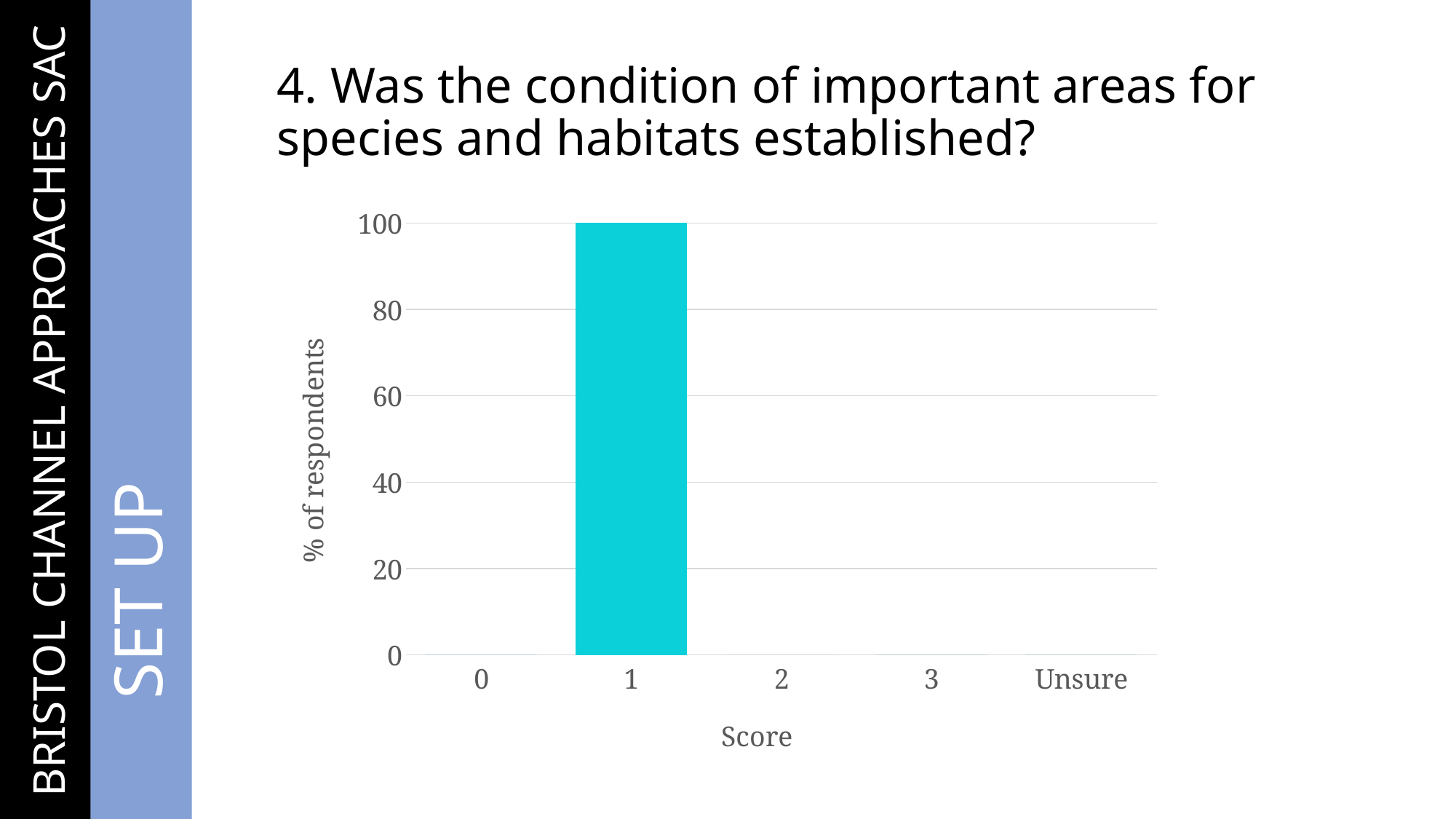
What is the difference between the value for score 1 and the value for score 0? 100 What percentage of respondents gave a score of 1? 100 Which score category has the highest percentage of respondents? 1 How many score categories are shown on the x axis? 5 How many score categories have a value above 0? 1 What is the label of the y axis? % of respondents Is the value for score 1 greater or less than 80? greater Which is larger, the value for score 1 or the value for score 3? score 1 What percentage of respondents gave a score of 2? 0 What percentage of respondents answered Unsure? 0 What is the label of the x axis? Score What kind of chart is shown on the slide? bar chart